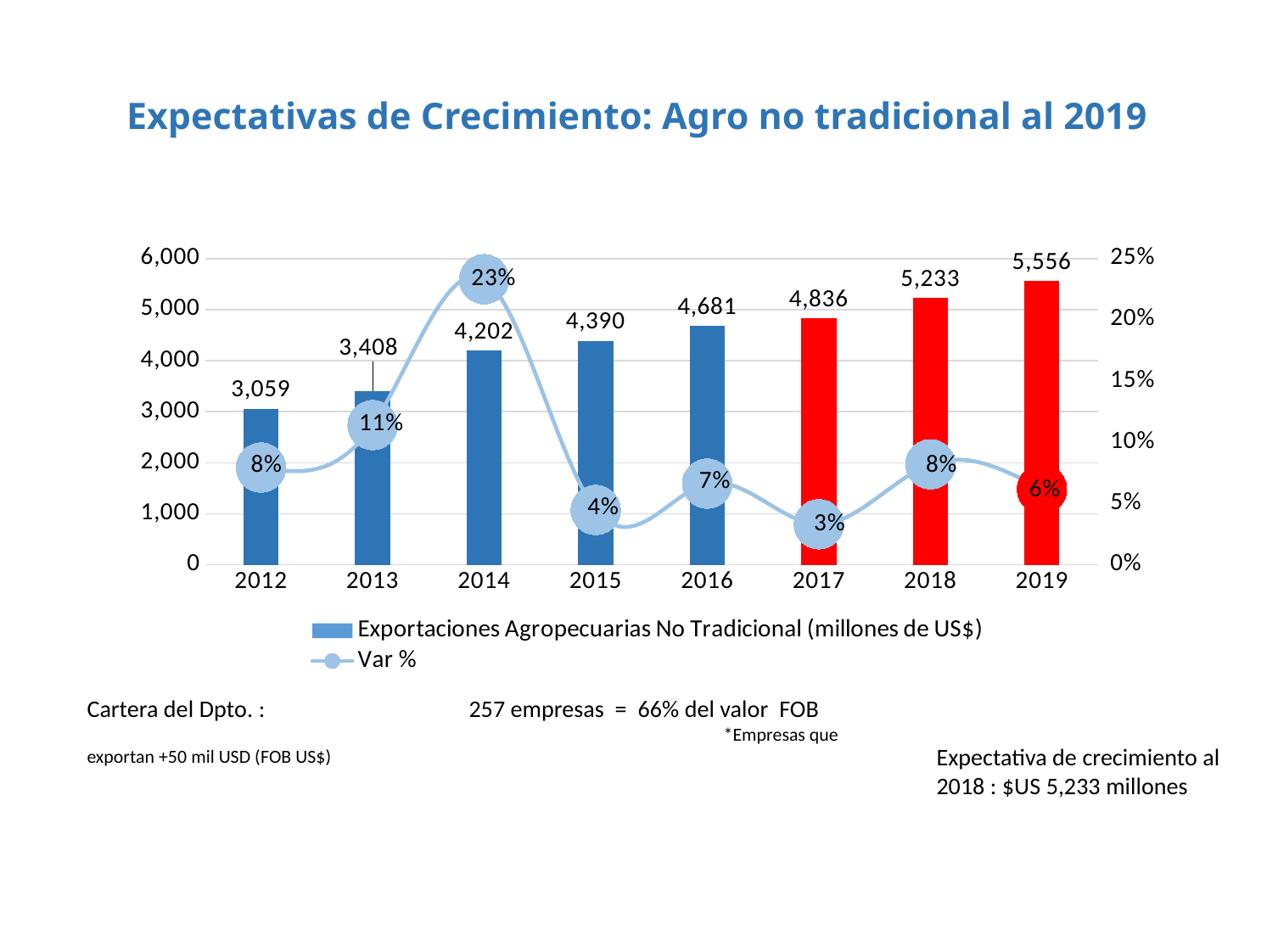
How many years are shown on the x axis? 8 Which year has the highest Exportaciones Agropecuarias No Tradicional value? 2019 What kind of chart is shown on the slide? Combined bar and line chart What is the value of Exportaciones Agropecuarias No Tradicional for 2019? 5,556 Do the Exportaciones Agropecuarias No Tradicional values rise or fall from 2012 to 2019? Rise What is the difference between the Exportaciones Agropecuarias No Tradicional values for 2018 and 2017? 397 Which year has the lowest Var % value? 2017 What is the title of the chart? Expectativas de Crecimiento: Agro no tradicional al 2019 How many series does the legend list? 2 What is the Var % value for 2014? 23% Which is larger, the Var % for 2013 or the Var % for 2016? 2013 What is the value of Exportaciones Agropecuarias No Tradicional for 2014? 4,202